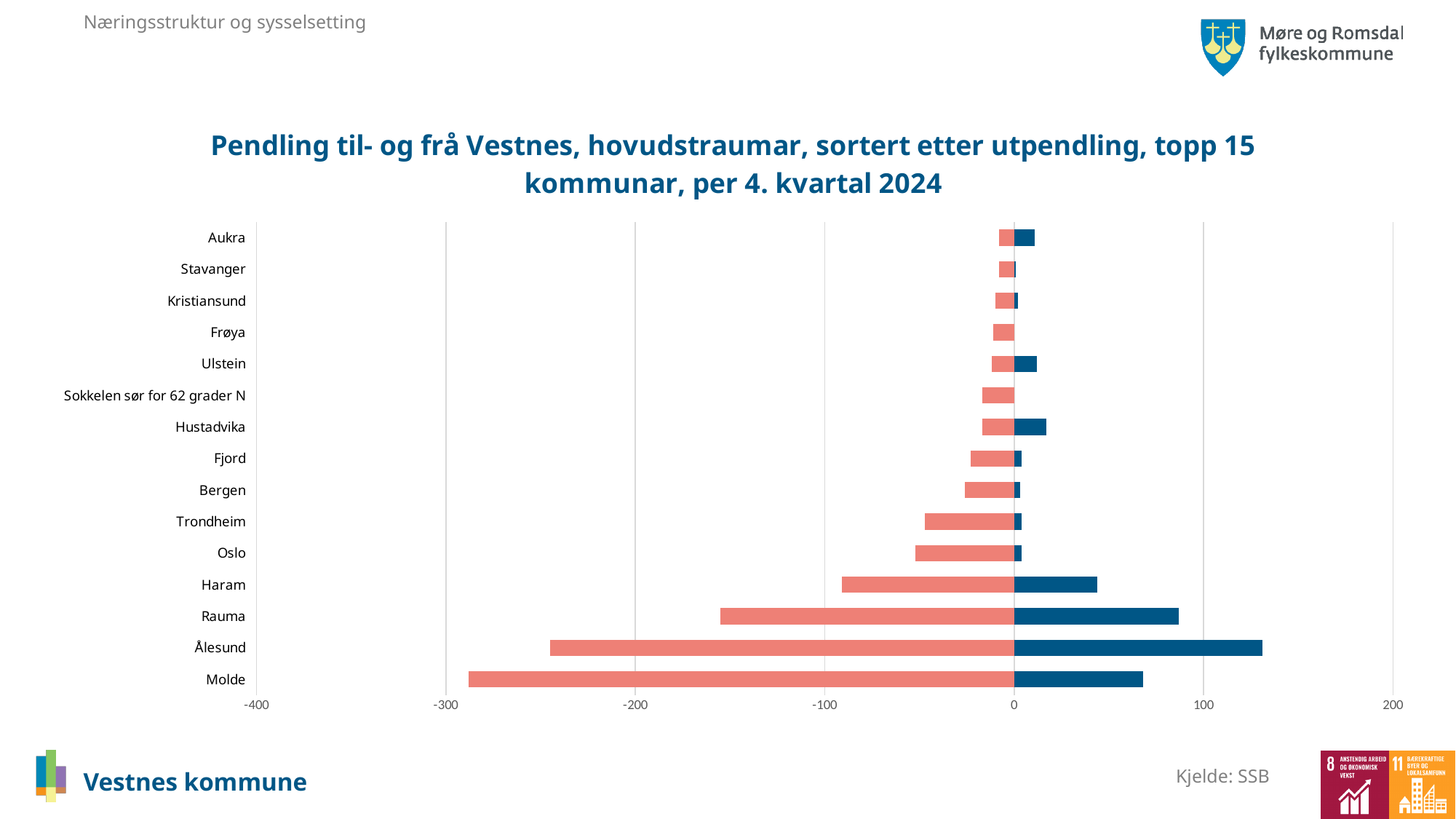
Is the negative (red) value for Molde greater or less than -200? less Which has the larger positive (blue) bar, Molde or Ålesund? Ålesund What kind of chart is shown on the slide? bar chart Is the negative (red) value for Haram greater or less than -100? greater What is the title of the chart? Pendling til- og frå Vestnes, hovudstraumar, sortert etter utpendling, topp 15 kommunar, per 4. kvartal 2024 How many municipalities/categories are listed on the vertical axis of the chart? 15 Is the positive (blue) value for Ålesund greater or less than 100? greater Which category has the longest negative (red) bar? Molde Which category has the longest positive (blue) bar? Ålesund Which has the larger positive (blue) bar, Rauma or Haram? Rauma